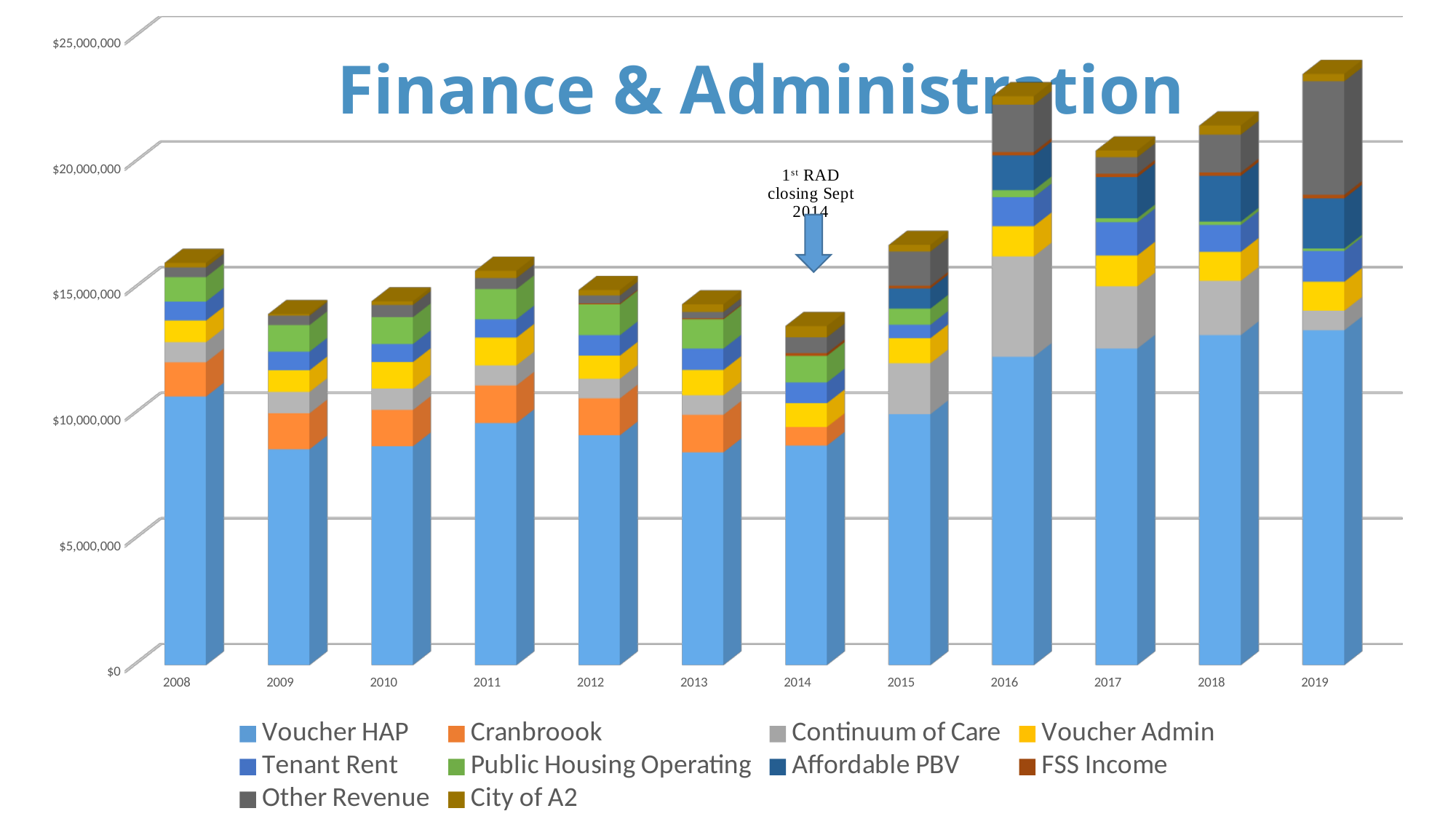
Is the Voucher HAP value for 2019 greater or less than $10,000,000? greater Do the stacked bar totals generally rise or fall from 2014 to 2019? rise Which year has the tallest stacked bar (highest total)? 2019 Which year has the larger total, 2016 or 2017? 2016 What is the title of the chart? Finance & Administration What kind of chart is shown on the slide? Stacked bar chart Is the total for 2019 greater or less than $20,000,000? greater How many years are shown along the x axis of the chart? 12 Which year has the larger total, 2008 or 2009? 2008 Is the Voucher HAP value for 2013 greater or less than $10,000,000? less How many series does the legend list? 10